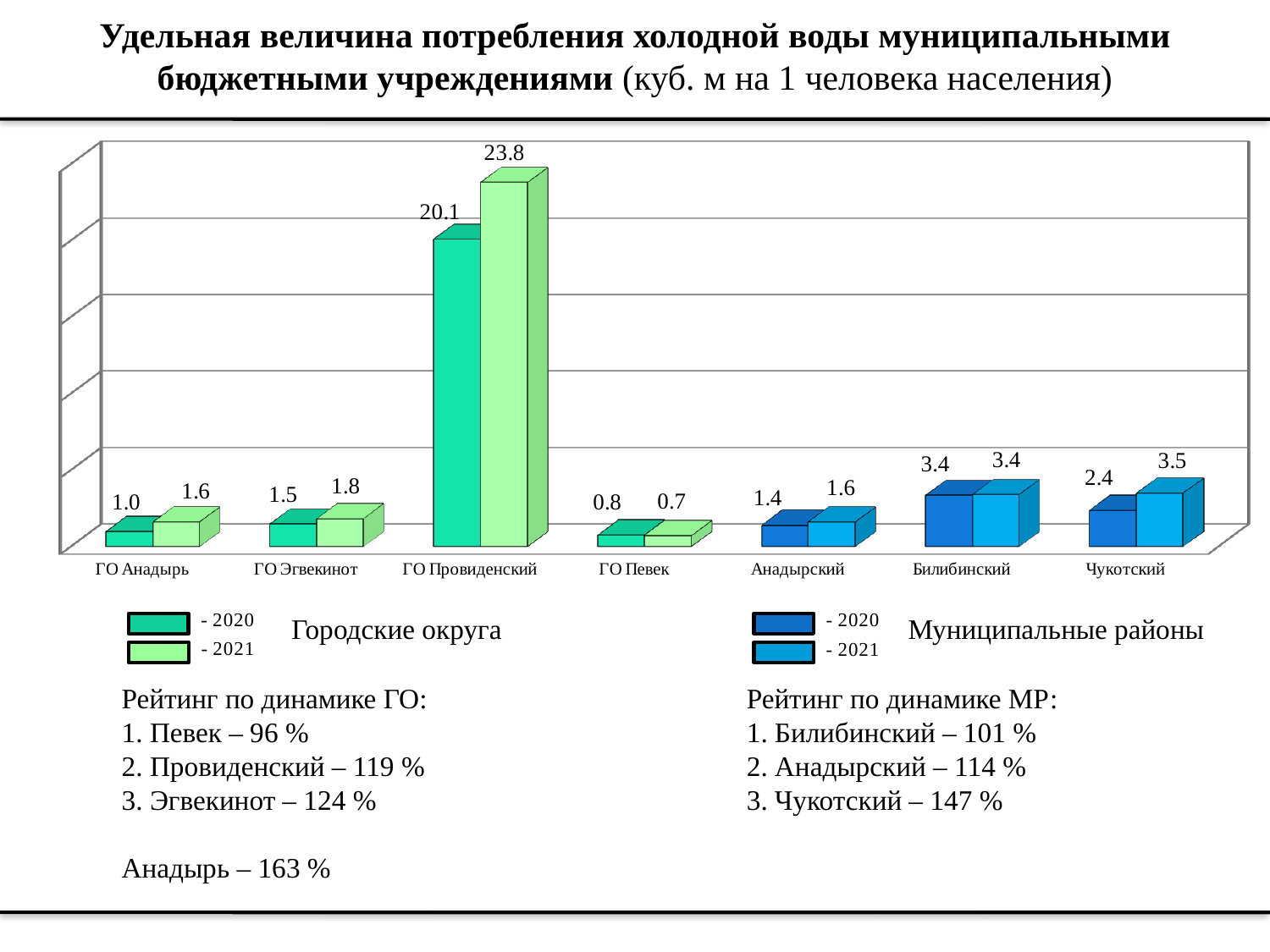
What kind of chart is shown on the slide? bar chart Which two years does the legend list? 2020 and 2021 What is the 2020 value for ГО Анадырь? 1.0 Which category has the highest 2021 value? ГО Провиденский What is the 2021 value for Чукотский? 3.5 What is the difference between the 2021 values for Чукотский and Билибинский? 0.1 Which category has the lowest 2021 value? ГО Певек What is the 2021 value for ГО Провиденский? 23.8 How many categories are shown on the x axis? 7 What is the difference between the 2021 and 2020 values for ГО Провиденский? 3.7 What is the 2020 value for ГО Певек? 0.8 Which is larger for Чукотский: the 2020 value or the 2021 value? 2021